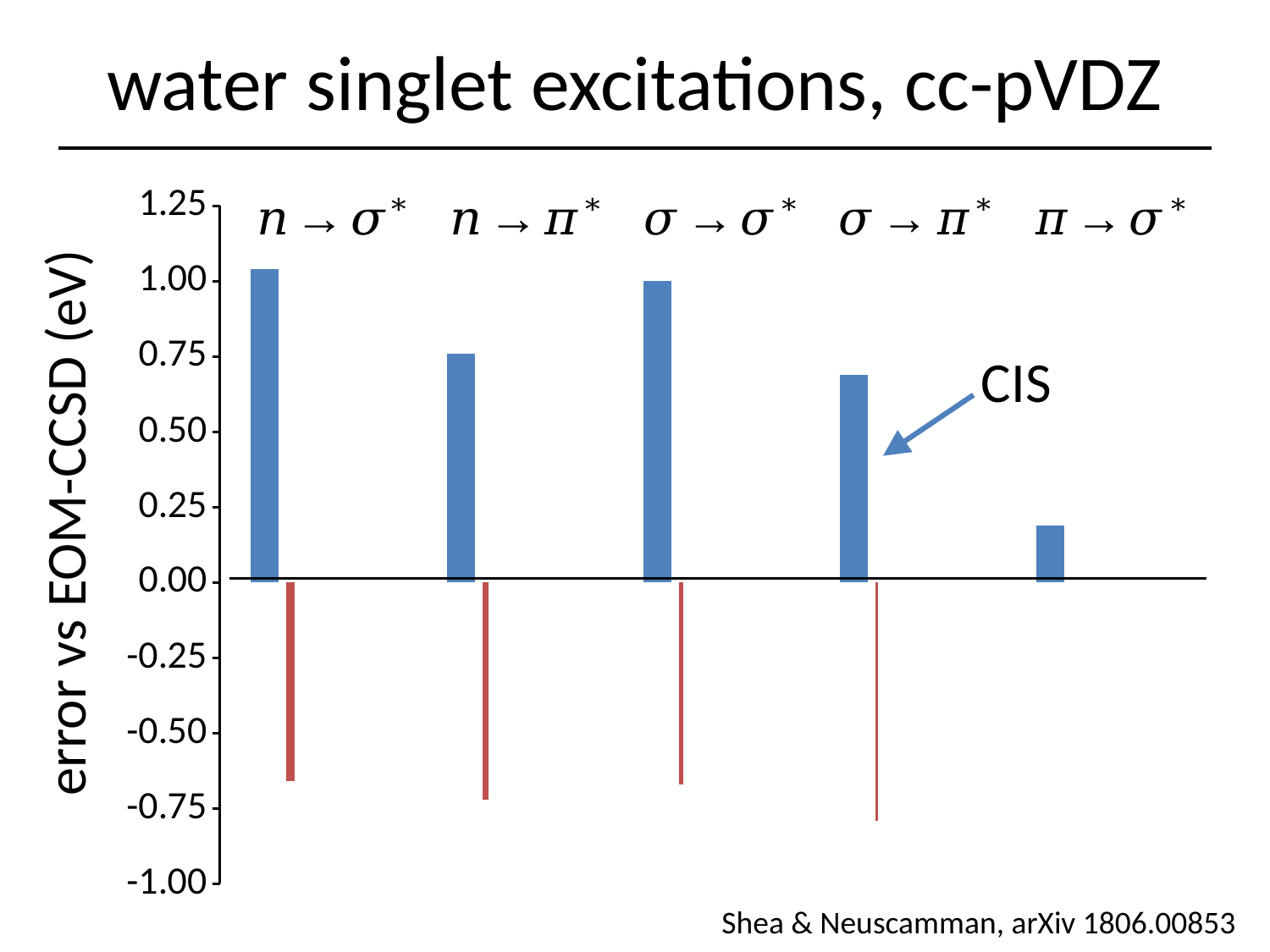
Is the red bar value for n → σ* greater or less than -0.50? less Which has the larger CIS (blue) error, n → π* or σ → π*? n → π* What is the title of the chart? water singlet excitations, cc-pVDZ What is the label on the vertical axis? error vs EOM-CCSD (eV) Which excitation has the most negative red bar value? σ → π* Which excitation has the smallest CIS (blue) error? π → σ* Is the CIS (blue) error for π → σ* greater or less than 0.25? less Is the CIS (blue) error for σ → π* greater or less than 0.50? greater What kind of chart is shown on the slide? bar chart How many excitation categories are shown along the x axis? 5 Which has the larger CIS (blue) error, n → σ* or π → σ*? n → σ*